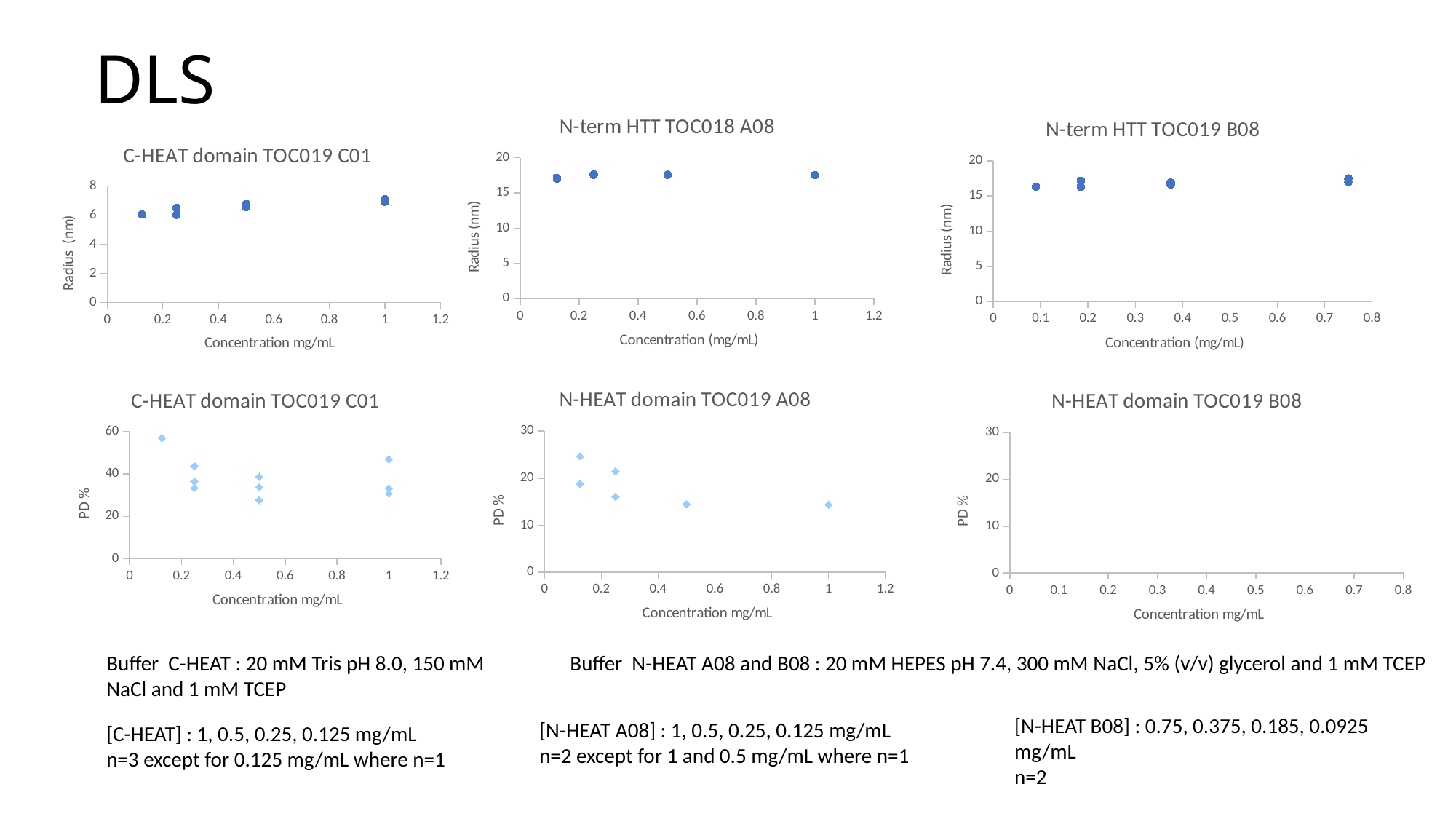
In the chart titled "N-term HTT TOC019 B08", is the radius at 0.75 mg/mL greater or less than 10? greater In the chart titled "N-term HTT TOC018 A08", is the radius at 1 mg/mL greater or less than 15? greater In the chart titled "N-HEAT domain TOC019 A08", do the PD % values rise or fall as concentration increases? fall What is the x-axis label of the chart titled "N-term HTT TOC018 A08"? Concentration (mg/mL) In the chart titled "N-HEAT domain TOC019 A08", is the PD % at 1 mg/mL greater or less than 20? less What kind of chart is the top-left chart titled "C-HEAT domain TOC019 C01"? scatter chart In the chart titled "N-HEAT domain TOC019 A08", which is larger: the PD % at 0.5 mg/mL or the highest PD % at 0.125 mg/mL? the highest PD % at 0.125 mg/mL Does the chart titled "N-HEAT domain TOC019 B08" show any plotted data points? No